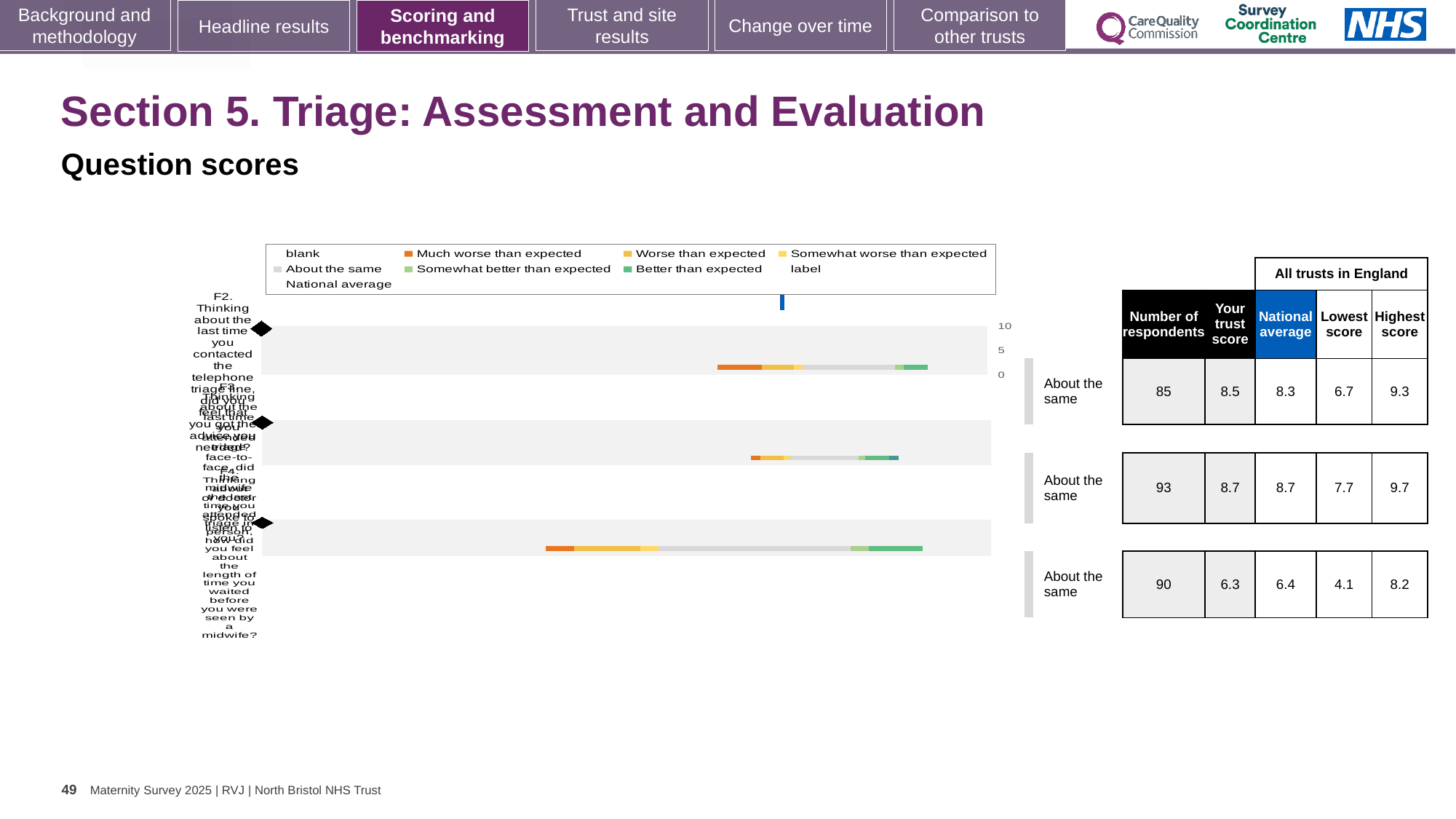
What kind of chart is shown on the slide? bar chart In the table beside the chart, what is the number of respondents for the first question row (F2)? 85 In the table beside the chart, which question row has the highest number of respondents? F3 (93) What benchmark category is shown next to each bar in the chart? About the same In the table beside the chart, which question row has the lowest trust score? F4 (6.3) In the table beside the chart, what is the difference between the highest score and the lowest score for the third question row (F4)? 4.1 In the table beside the chart, is the trust score for the first question row (F2) larger or smaller than its national average? larger In the table beside the chart, what is the trust score for the third question row (F4)? 6.3 In the table beside the chart, what is the national average for the second question row (F3)? 8.7 How many horizontal bars (question rows) are plotted in the chart? 3 What is the highest tick value shown on the chart's axis? 10 Which legend entry is shown in orange in the chart? Much worse than expected